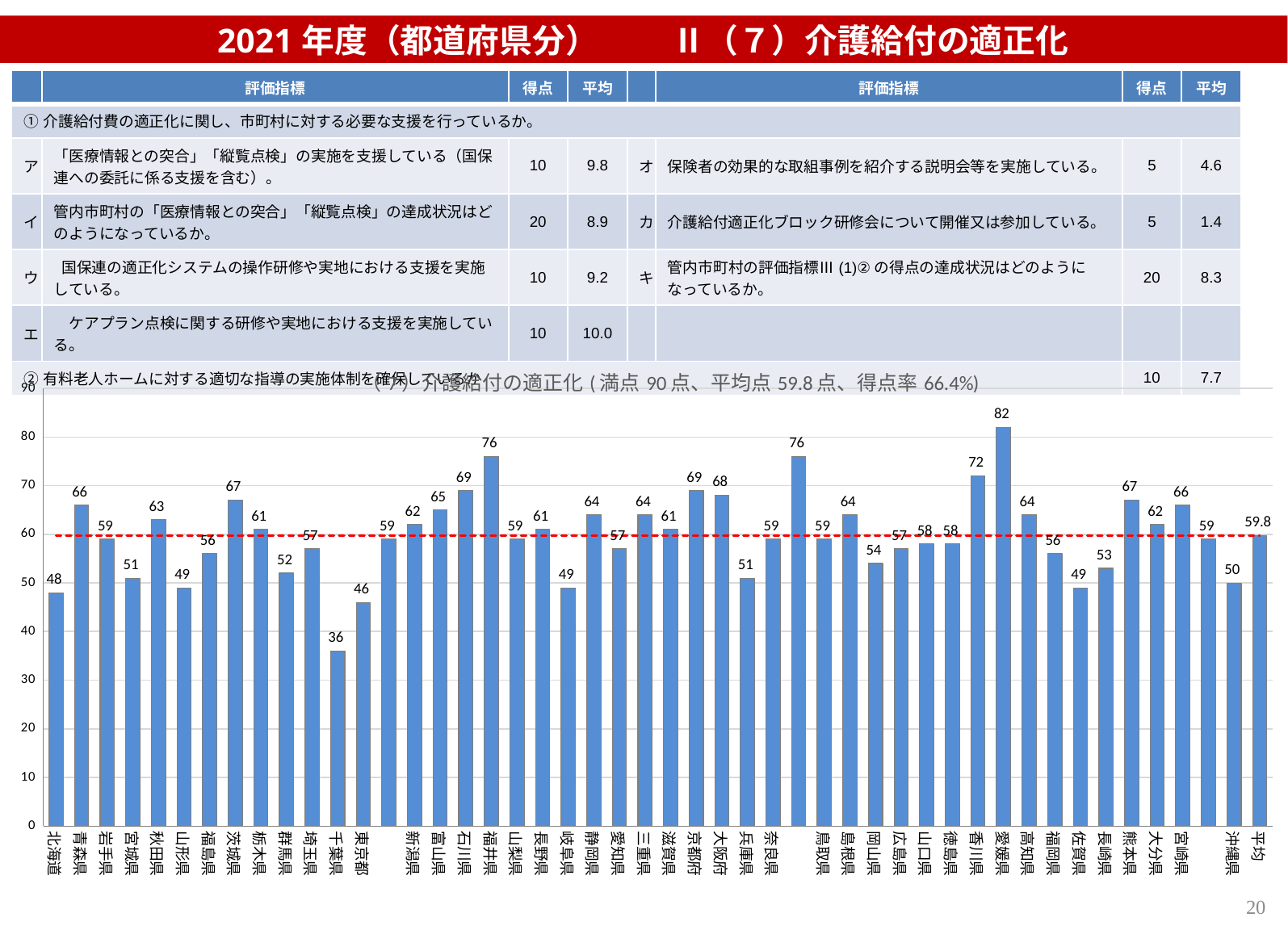
Which prefecture has the lowest value in the bar chart? 千葉県 Which prefecture has the highest value in the bar chart? 愛媛県 What is the value for 千葉県 in the bar chart? 36 What value does the red dashed horizontal line in the chart mark? 59.8 What is the value for 北海道 in the bar chart? 48 Is the value for 東京都 greater or less than 50? less What is the difference between the values for 愛媛県 and 千葉県? 46 What kind of chart is shown on the slide? bar chart What is the difference between the values for 香川県 and 岡山県? 18 Which has a larger value, 福井県 or 東京都? 福井県 What is the value for 愛媛県 in the bar chart? 82 What is the value shown for 平均 at the right end of the bar chart? 59.8